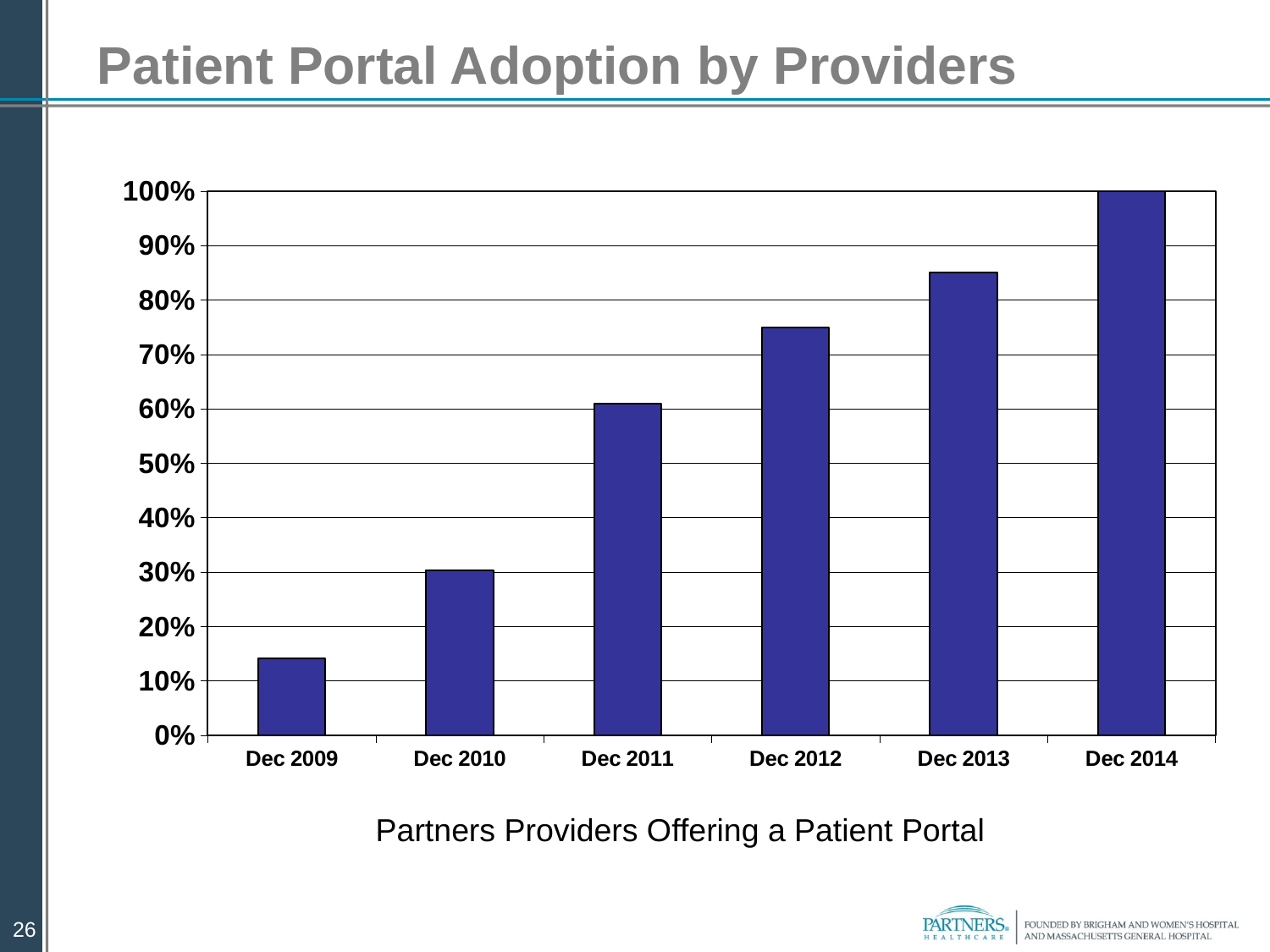
How many bars (time points) are plotted in the chart? 6 What is the value for Dec 2014? 100% Is the value for Dec 2010 greater or less than 40%? less Which is larger, the value for Dec 2012 or the value for Dec 2010? Dec 2012 Which time point has the highest value in the chart? Dec 2014 What type of chart is shown on the slide? bar chart Is the value for Dec 2009 greater or less than 20%? less Is the value for Dec 2013 greater or less than 80%? greater Which time point has the lowest value in the chart? Dec 2009 Do the values rise or fall from Dec 2009 to Dec 2014? rise What is the caption shown below the chart? Partners Providers Offering a Patient Portal